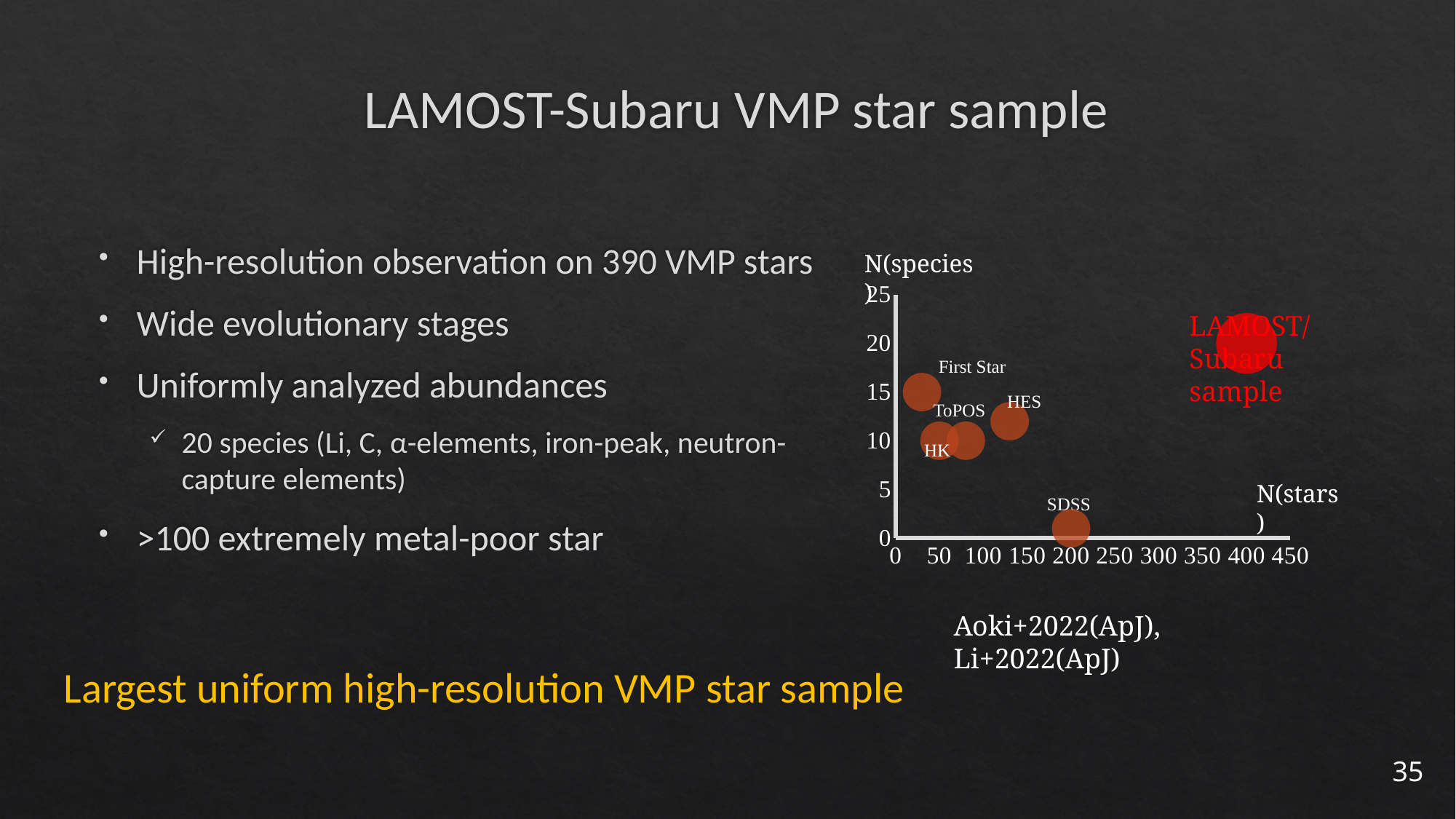
Is the N(stars) value for the LAMOST/Subaru sample greater or less than 350? greater Is the N(species) value for the LAMOST/Subaru sample greater or less than 15? greater Which sample has the lowest N(species) in the chart? SDSS Which has the larger N(stars), SDSS or HK? SDSS What kind of chart is shown on the slide? Bubble (scatter) chart Which sample has the highest N(species) in the chart? LAMOST/Subaru sample Is the N(stars) value for First Star greater or less than 100? less How many labelled data points are plotted in the chart? 6 Which sample has the highest N(stars) in the chart? LAMOST/Subaru sample What is the label of the horizontal axis of the chart? N(stars) Which has the larger N(species), HES or SDSS? HES